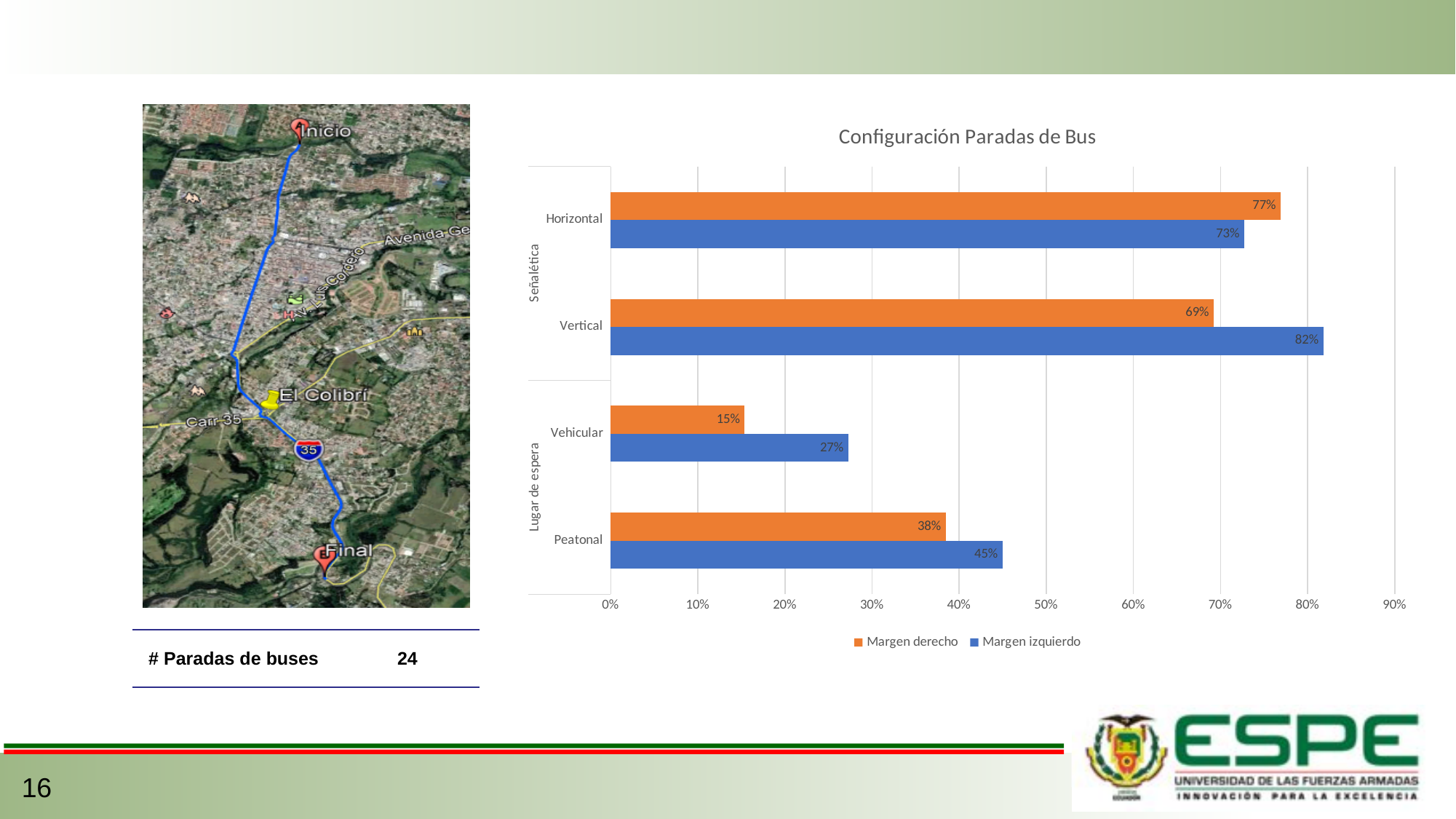
How many series does the legend list? 2 Which category has the lowest Margen derecho value? Vehicular What is the title of the chart? Configuración Paradas de Bus What kind of chart is shown on the slide? Bar chart What is the value for Margen izquierdo in the Vertical category? 82% How many categories are shown on the chart? 4 Which category has the highest Margen izquierdo value? Vertical What is the value for Margen derecho in the Vehicular category? 15% What is the difference between Margen izquierdo and Margen derecho in the Vertical category? 13% Which is larger in the Horizontal category, Margen derecho or Margen izquierdo? Margen derecho What is the value for Margen derecho in the Horizontal category? 77% What is the value for Margen izquierdo in the Peatonal category? 45%